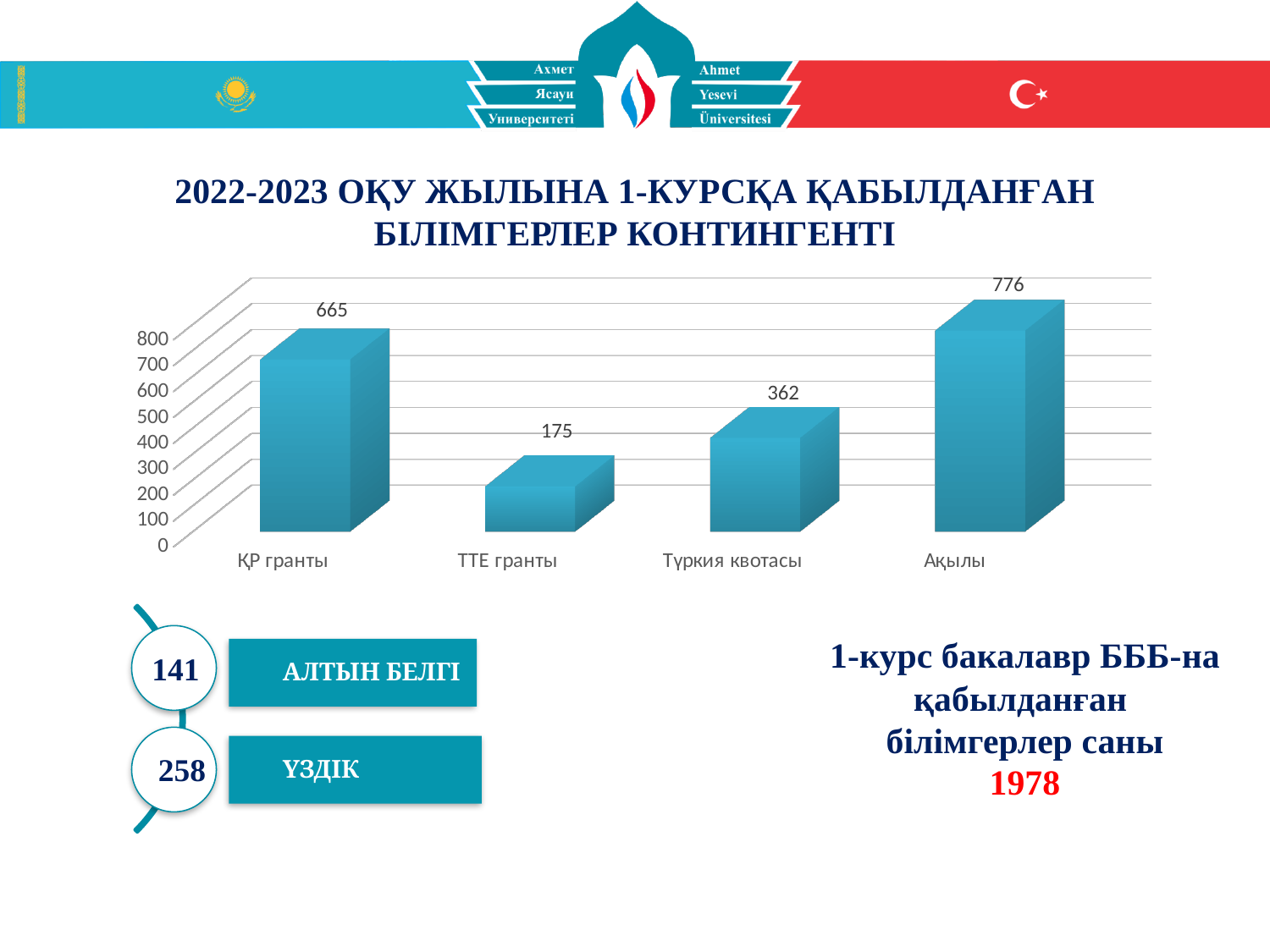
How many categories are shown on the chart? 4 What is the total of the four values shown on the chart? 1978 What is the value for Ақылы? 776 What is the difference between the values for Түркия квотасы and ТТЕ гранты? 187 What is the value for ТТЕ гранты? 175 What kind of chart is shown on the slide? bar chart What is the value for Түркия квотасы? 362 What is the difference between the values for Ақылы and ҚР гранты? 111 Which category has the lowest value? ТТЕ гранты Which category has the highest value? Ақылы What is the value for ҚР гранты? 665 Which is larger, the value for ҚР гранты or the value for Түркия квотасы? ҚР гранты